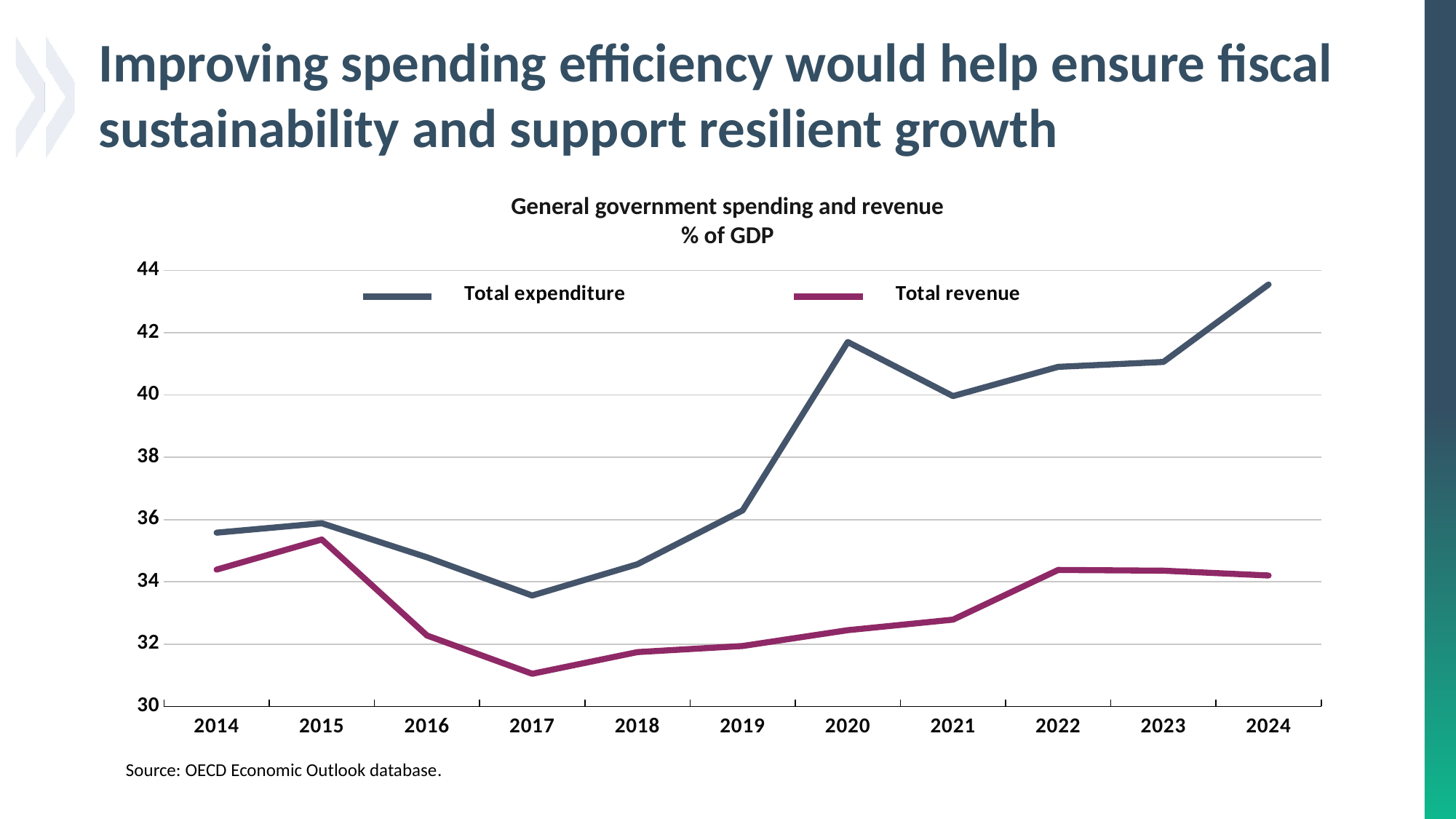
In which year is Total revenue highest? 2015 How many years are shown on the x axis? 11 In which year is Total expenditure lowest? 2017 Does Total expenditure rise or fall from 2021 to 2024? rise In which year is Total expenditure highest? 2024 How many series does the legend list? 2 Is the value for Total expenditure in 2020 greater or less than 40? greater Which is larger: Total expenditure in 2024 or Total expenditure in 2020? Total expenditure in 2024 What is the title of the chart? General government spending and revenue % of GDP Is the value for Total revenue in 2017 greater or less than 32? less What kind of chart is shown on the slide? line chart In which year is Total revenue lowest? 2017